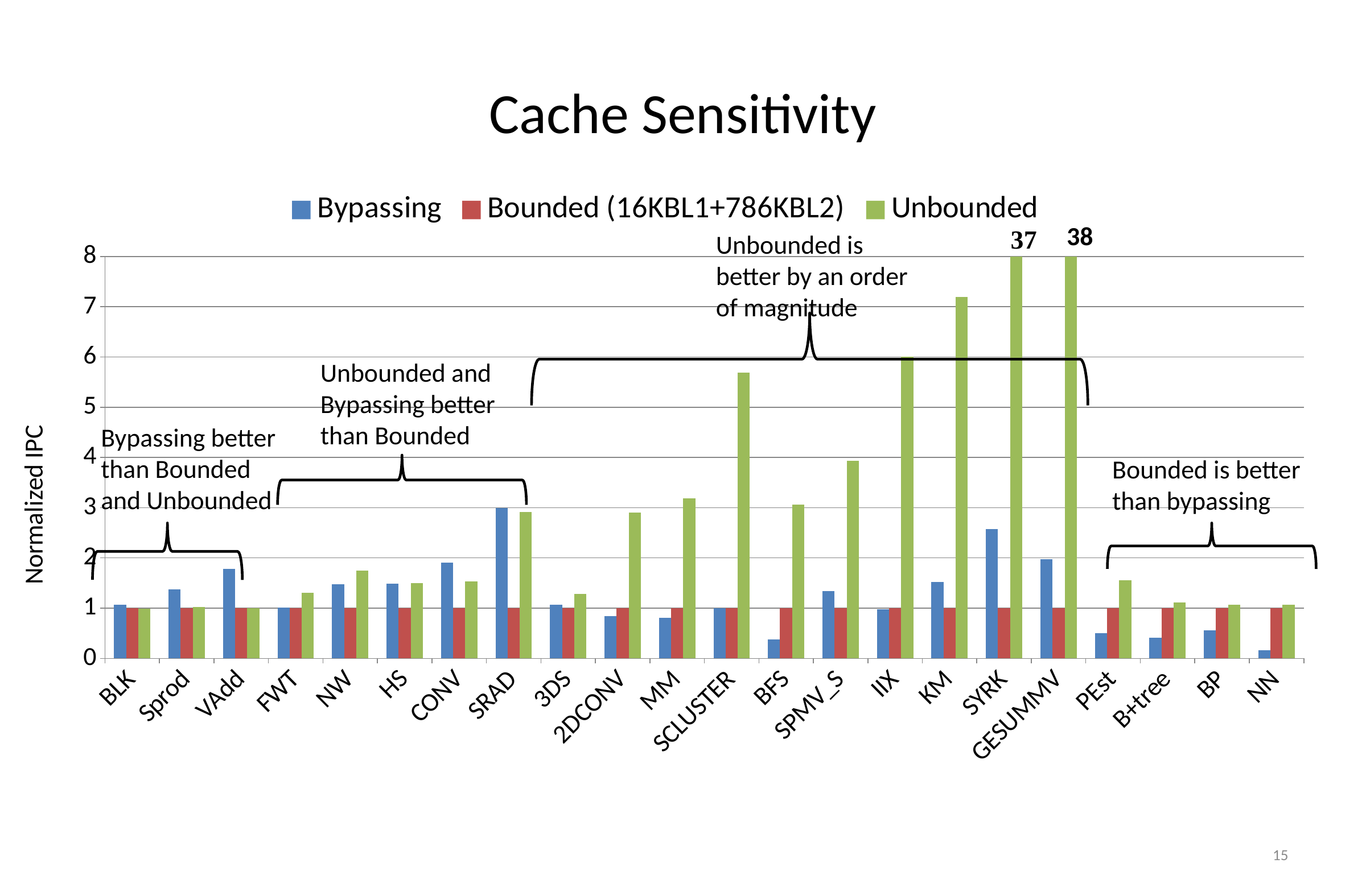
What is the Unbounded value for GESUMMV? 38 Is the Bypassing value for BFS greater or less than 1? less What is the label of the y axis? Normalized IPC What is the difference between the Unbounded values for GESUMMV and SYRK? 1 How many series does the legend list? 3 What kind of chart is shown on the slide? bar chart Which benchmark has the highest Unbounded value? GESUMMV For KM, which is larger: the Bypassing value or the Unbounded value? Unbounded Is the Unbounded value for SCLUSTER greater or less than 5? greater How many benchmark categories are shown on the x axis? 22 What is the Unbounded value for SYRK? 37 Which benchmark has the lowest Bypassing value? NN